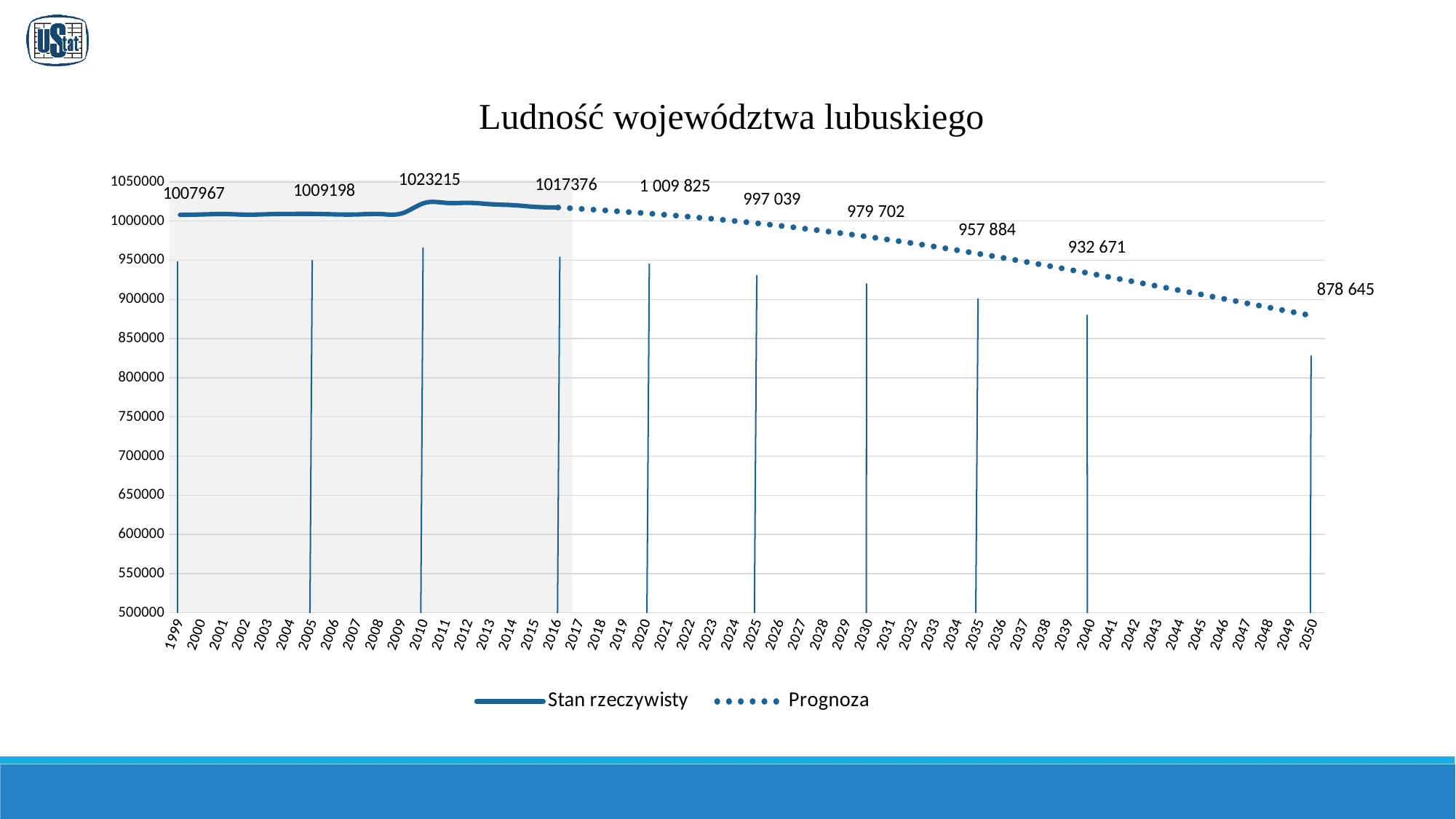
What is the labelled population value for 2016? 1017376 What is the labelled population value for 2010? 1023215 What type of chart is shown on the slide? line chart What is the forecast (Prognoza) value labelled for 2040? 932 671 Which labelled year has the highest population value? 2010 Which is larger, the labelled value for 1999 or for 2005? 2005 What is the difference between the labelled values for 2010 and 2016? 5839 Does the Prognoza (dotted) series rise or fall from 2017 to 2050? fall Which labelled year has the lowest population value? 2050 What is the title of the chart? Ludność województwa lubuskiego How many series does the legend list? 2 What is the forecast value labelled for 2050? 878 645